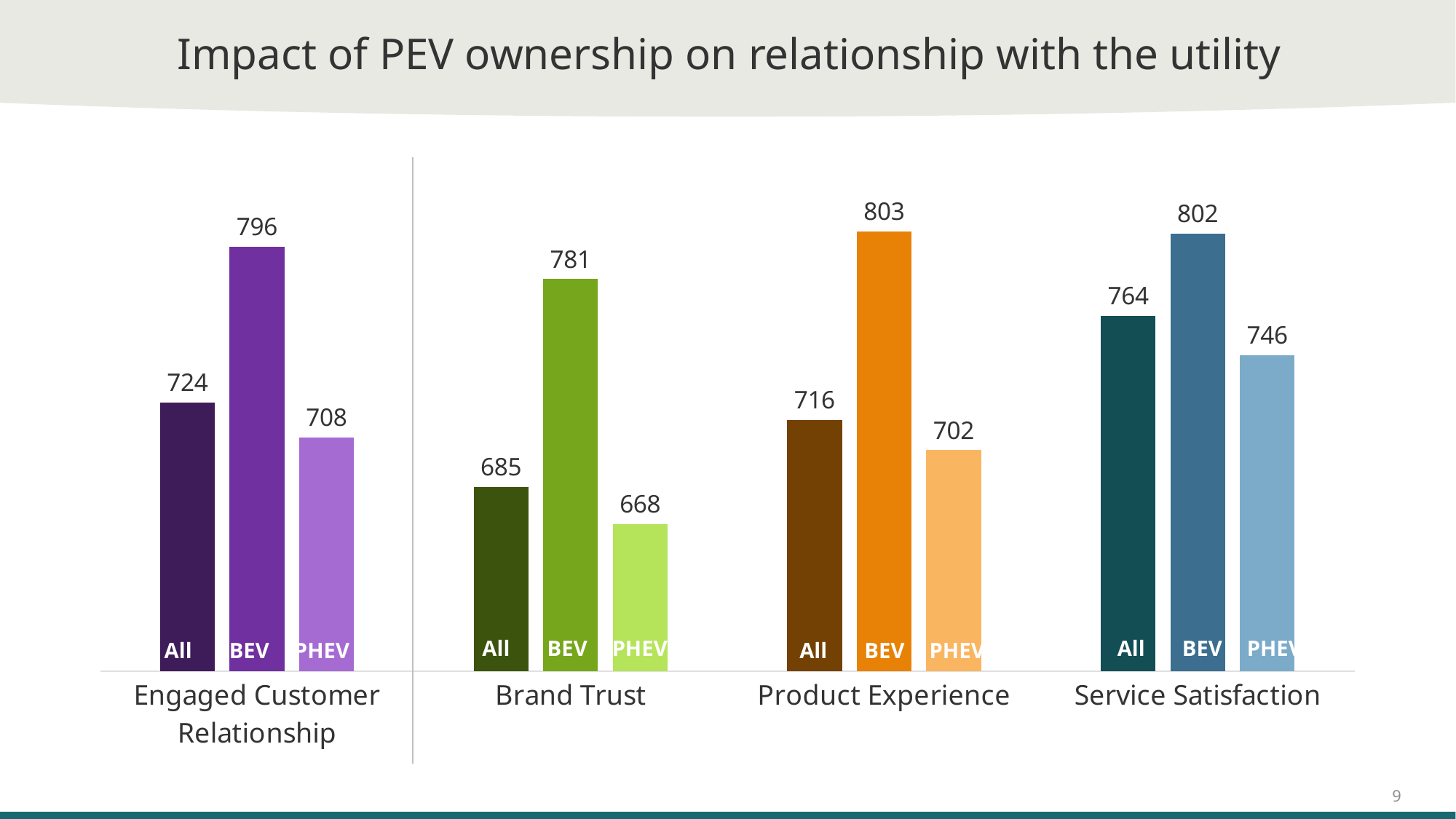
Which bar has the highest value on the chart? BEV under Product Experience What is the difference between the BEV and PHEV values under Engaged Customer Relationship? 88 What is the value for PHEV under Brand Trust? 668 What kind of chart is shown on the slide? Bar chart How many categories are shown along the x axis? 4 What is the value for PHEV under Service Satisfaction? 746 Which is larger: the All value under Brand Trust or the All value under Product Experience? All under Product Experience What is the title of the slide? Impact of PEV ownership on relationship with the utility What is the difference between the All and PHEV values under Service Satisfaction? 18 Which bar has the lowest value on the chart? PHEV under Brand Trust What is the value for All under Product Experience? 716 What is the value for BEV under Engaged Customer Relationship? 796